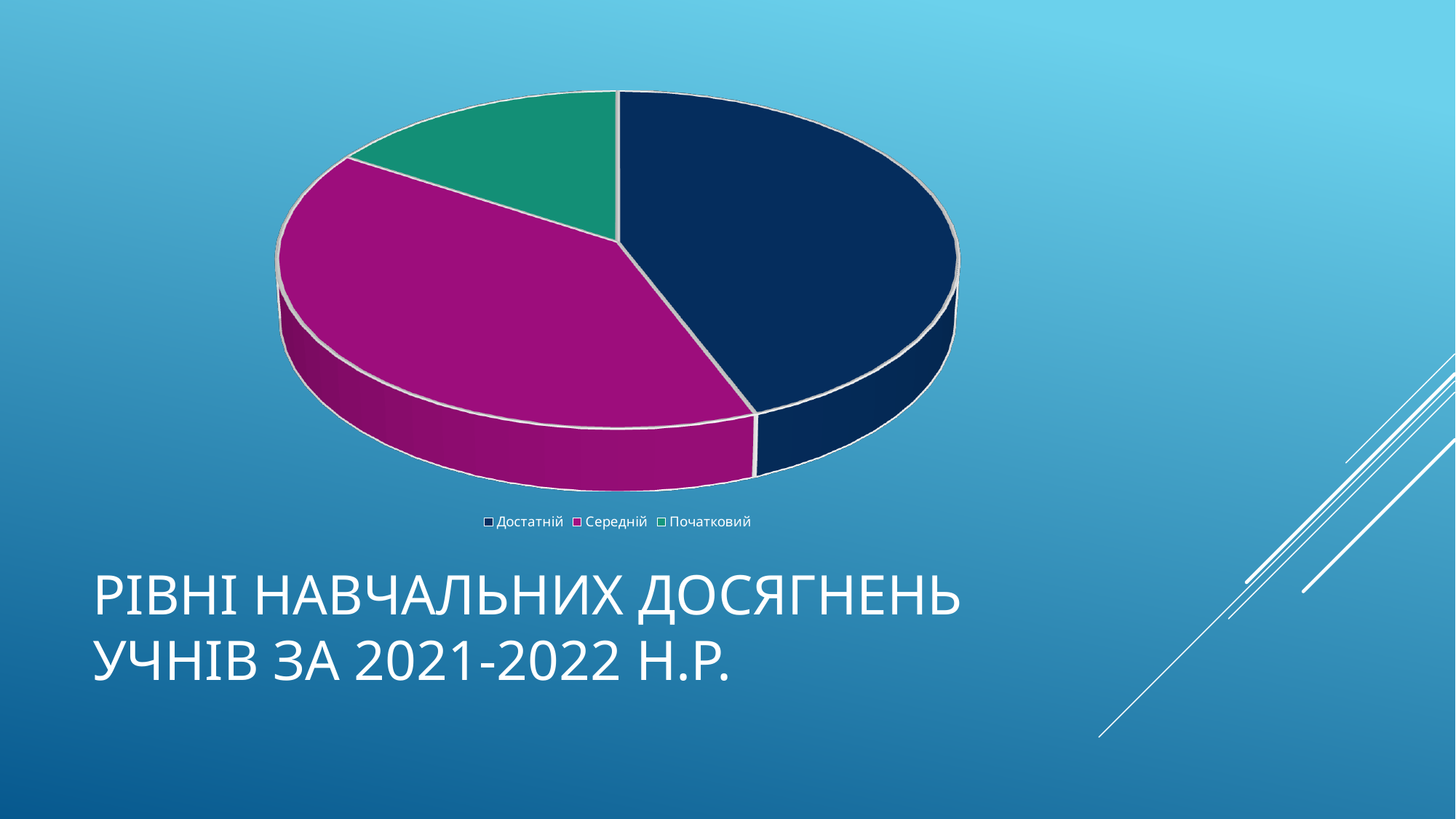
Which slice is larger, Середній or Початковий? Середній How many slices does the pie chart have? 3 Which category has the smallest slice in the pie chart? Початковий What kind of chart is shown on the slide? pie chart What colour is the Середній slice in the pie chart? magenta What is the title text shown below the pie chart? РІВНІ НАВЧАЛЬНИХ ДОСЯГНЕНЬ УЧНІВ ЗА 2021-2022 Н.Р. Which slice is larger, Достатній or Початковий? Достатній How many entries does the legend of the pie chart list? 3